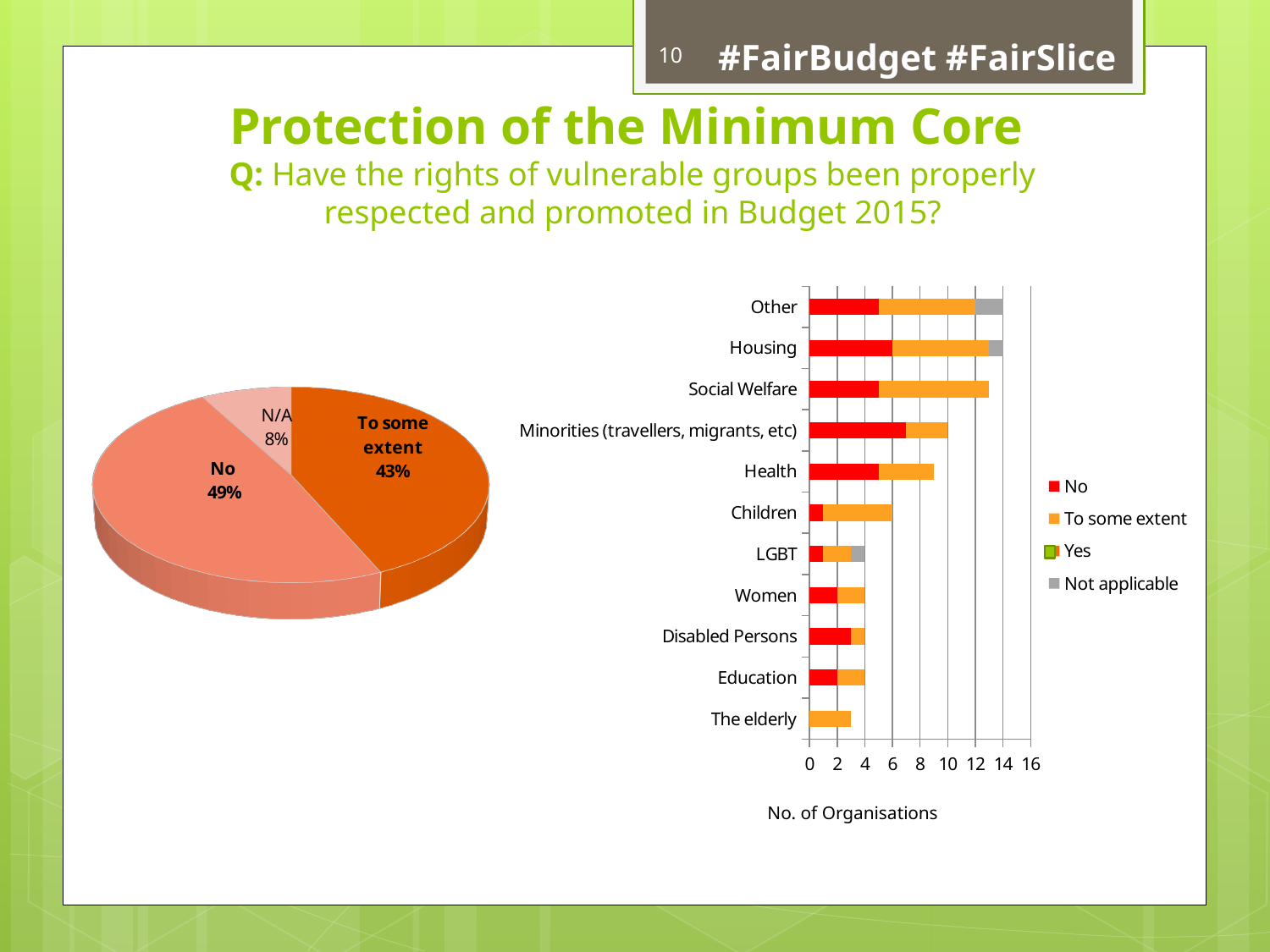
On the pie chart, which response has the smallest slice? N/A On the pie chart, which response has the largest slice? No On the bar chart on the right, is the total bar length for Social Welfare greater or less than 10? greater On the pie chart, what percentage of respondents answered "No"? 49% On the pie chart, what share is labelled "To some extent"? 43% On the bar chart on the right, is the total bar length for The elderly greater or less than 4? less On the bar chart on the right, how many series does the legend list? 4 On the pie chart, what is the difference in percentage points between "No" and "To some extent"? 6 On the bar chart on the right, how many categories are listed on the vertical axis? 11 On the pie chart, how many slices are there? 3 On the bar chart on the right, what is the title of the horizontal axis? No. of Organisations What kind of chart is shown on the right of the slide? Stacked bar chart